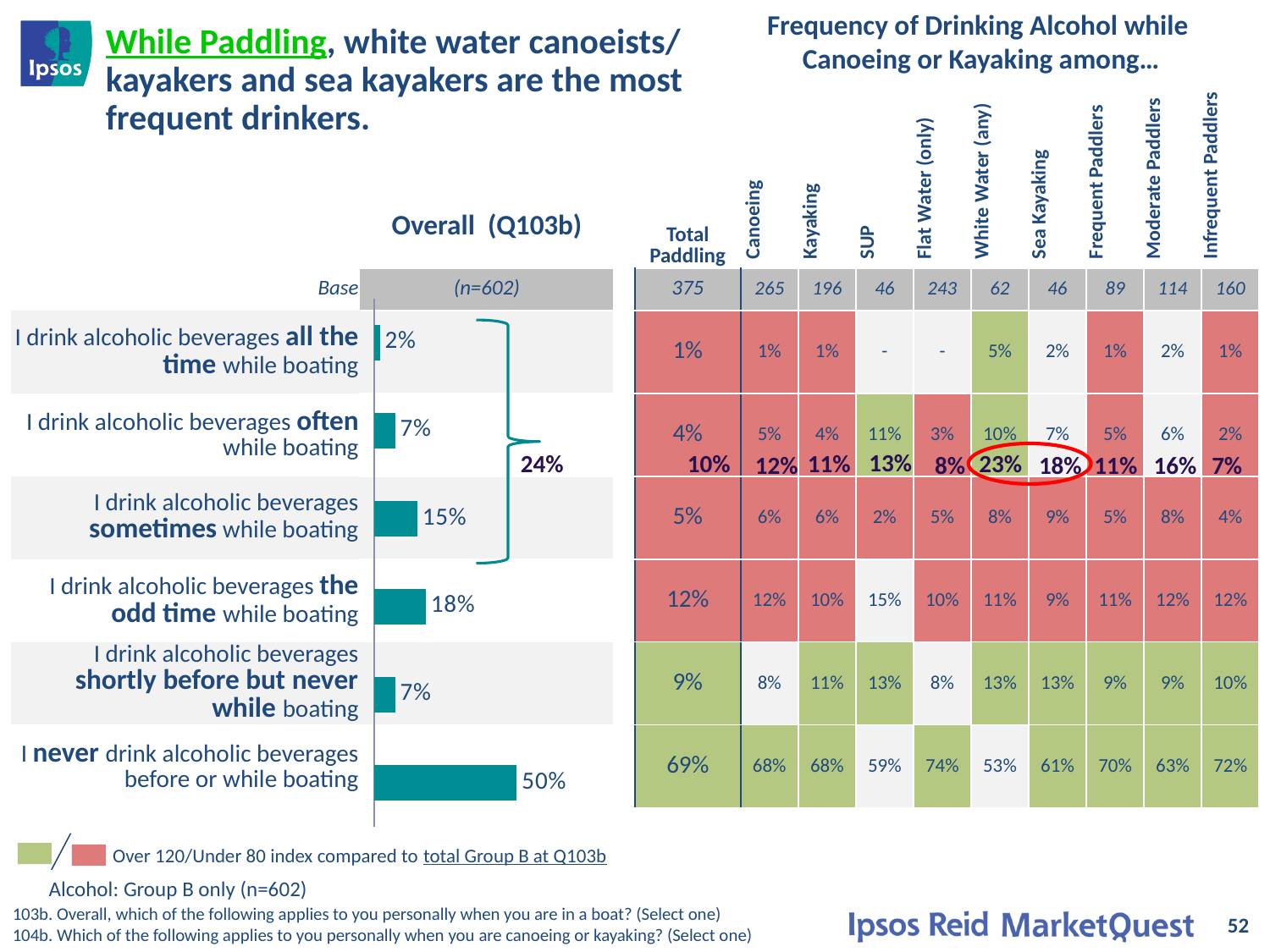
How many response categories are shown in the Overall (Q103b) bar chart? 6 In the Overall (Q103b) bar chart, what is the difference between the percentage who never drink before or while boating and the percentage who drink the odd time while boating? 32% In the Overall (Q103b) bar chart, what percentage say they drink alcoholic beverages all the time while boating? 2% What is the base size (n) shown for the Overall (Q103b) bar chart? n=602 In the Overall (Q103b) bar chart, what percentage say they drink alcoholic beverages the odd time while boating? 18% In the Overall (Q103b) bar chart, which response has the lowest percentage? I drink alcoholic beverages all the time while boating In the Overall (Q103b) bar chart, what combined percentage is shown by the bracket grouping the 'all the time', 'often' and 'sometimes' responses? 24% What type of chart is the Overall (Q103b) chart? Bar chart In the Overall (Q103b) bar chart, what percentage of respondents say they never drink alcoholic beverages before or while boating? 50% In the Overall (Q103b) bar chart, which response has the highest percentage? I never drink alcoholic beverages before or while boating In the Overall (Q103b) bar chart, what percentage say they drink alcoholic beverages sometimes while boating? 15% In the Overall (Q103b) bar chart, which is larger: the percentage who drink sometimes while boating or the percentage who drink often while boating? Sometimes while boating